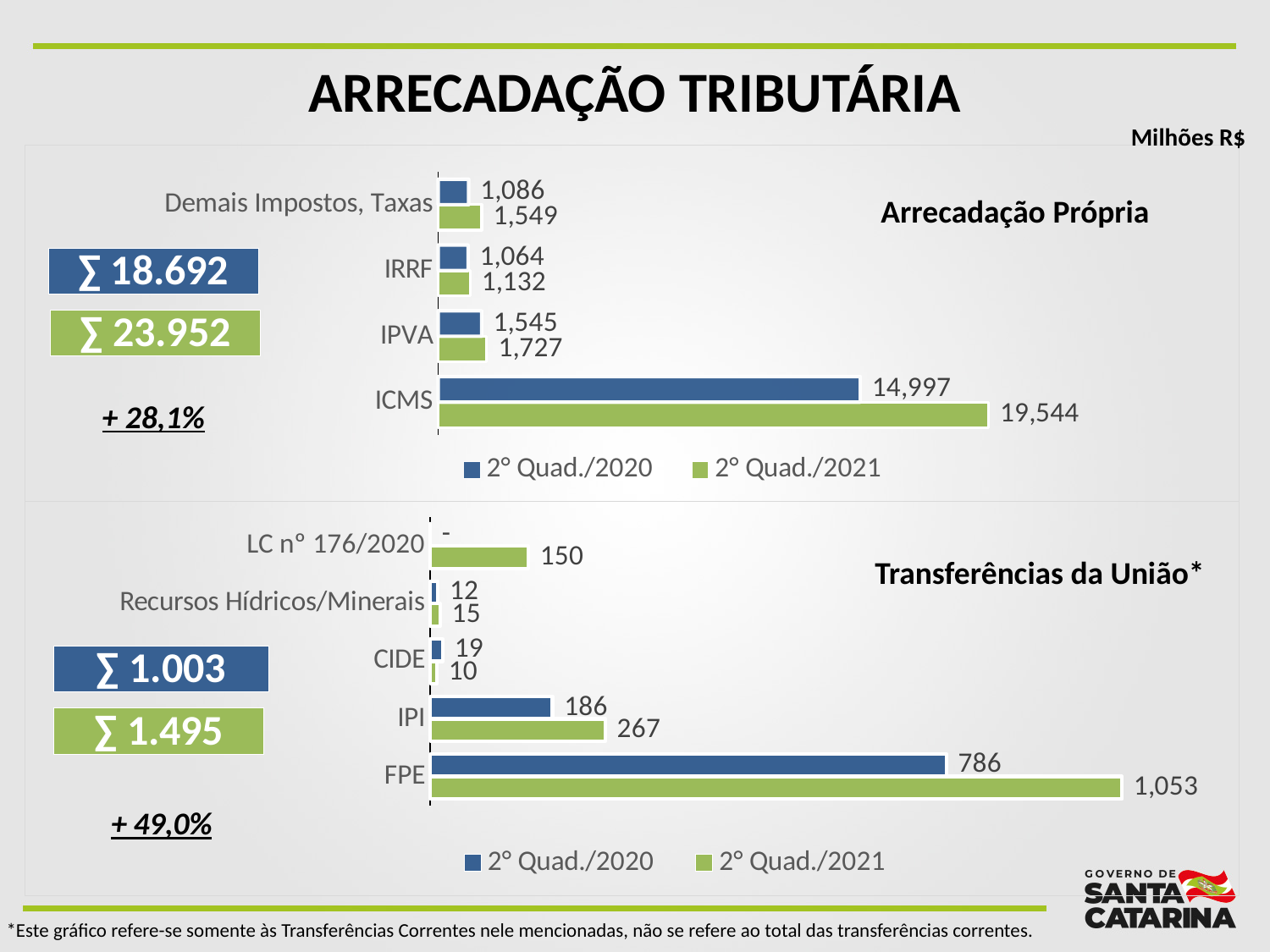
In the Arrecadação Própria chart, what is the difference between the ICMS values for 2° Quad./2021 and 2° Quad./2020? 4,547 In the Arrecadação Própria chart, which category has the highest value in 2° Quad./2021? ICMS In the Arrecadação Própria chart, which category has the lowest value in 2° Quad./2020? IRRF In the Transferências da União chart, how many series does the legend list? 2 In the Transferências da União chart, what is the difference between the IPI values for 2° Quad./2021 and 2° Quad./2020? 81 In the Transferências da União chart, what is the value for FPE in 2° Quad./2021? 1,053 In the Arrecadação Própria chart, what is the value for ICMS in 2° Quad./2021? 19,544 In the Arrecadação Própria chart, how many categories are shown? 4 What type of chart is the Transferências da União chart? Bar chart In the Arrecadação Própria chart, what is the value for IPVA in 2° Quad./2020? 1,545 In the Transferências da União chart, which is larger for CIDE: the 2° Quad./2020 value or the 2° Quad./2021 value? 2° Quad./2020 In the Transferências da União chart, what is the value for CIDE in 2° Quad./2020? 19